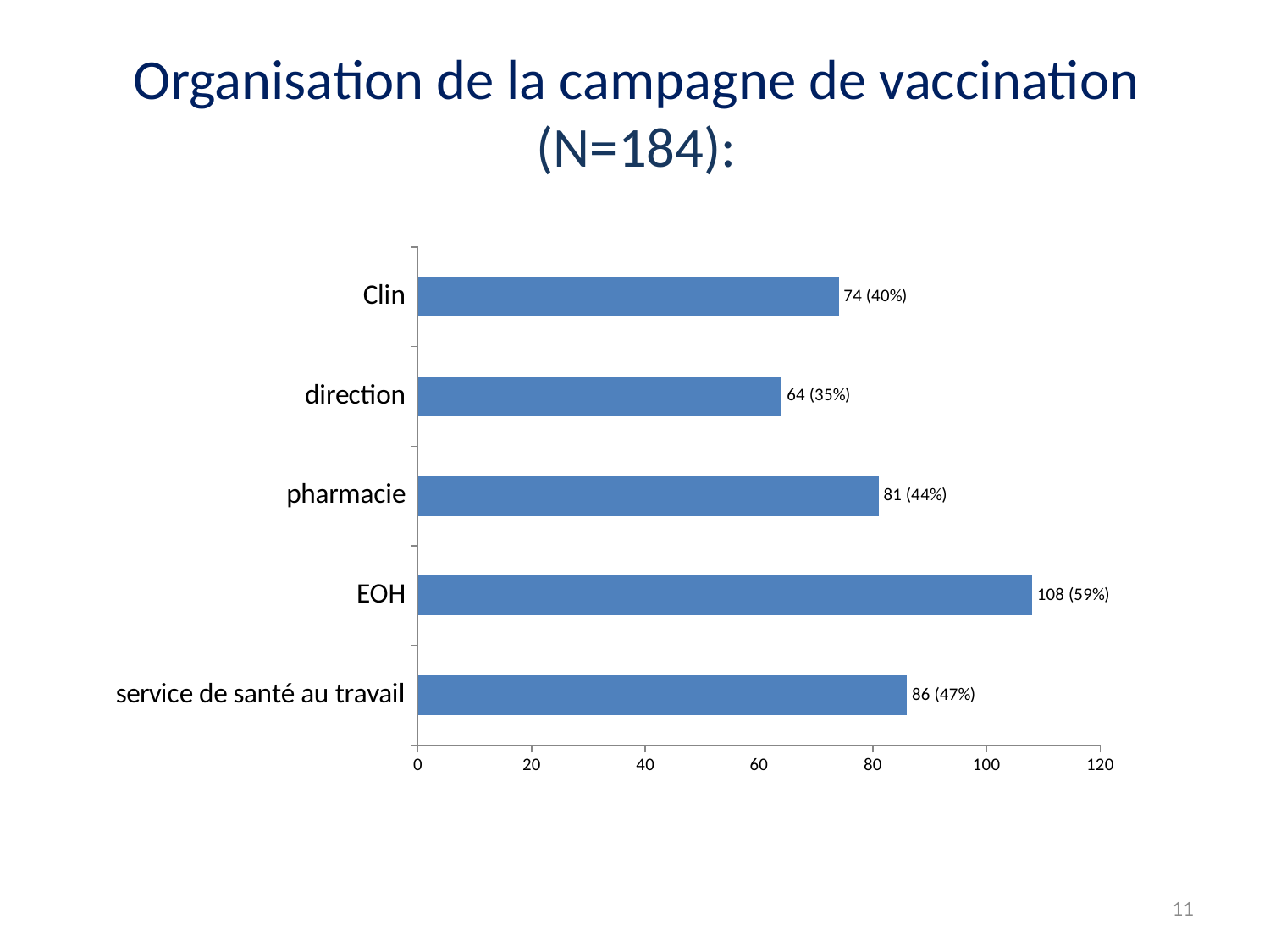
How many categories are shown in the chart? 5 Which category has the lowest value? direction Is the value for service de santé au travail greater or less than 80? greater Which is larger, the value for pharmacie or the value for Clin? pharmacie What kind of chart is shown on the slide? bar chart What is the value shown for direction? 64 (35%) What is the value shown for service de santé au travail? 86 (47%) What is the maximum value shown on the x axis? 120 What is the difference between the count for EOH and the count for Clin? 34 What percentage is shown for pharmacie? 44% Which category has the highest value? EOH What is the value shown for EOH? 108 (59%)